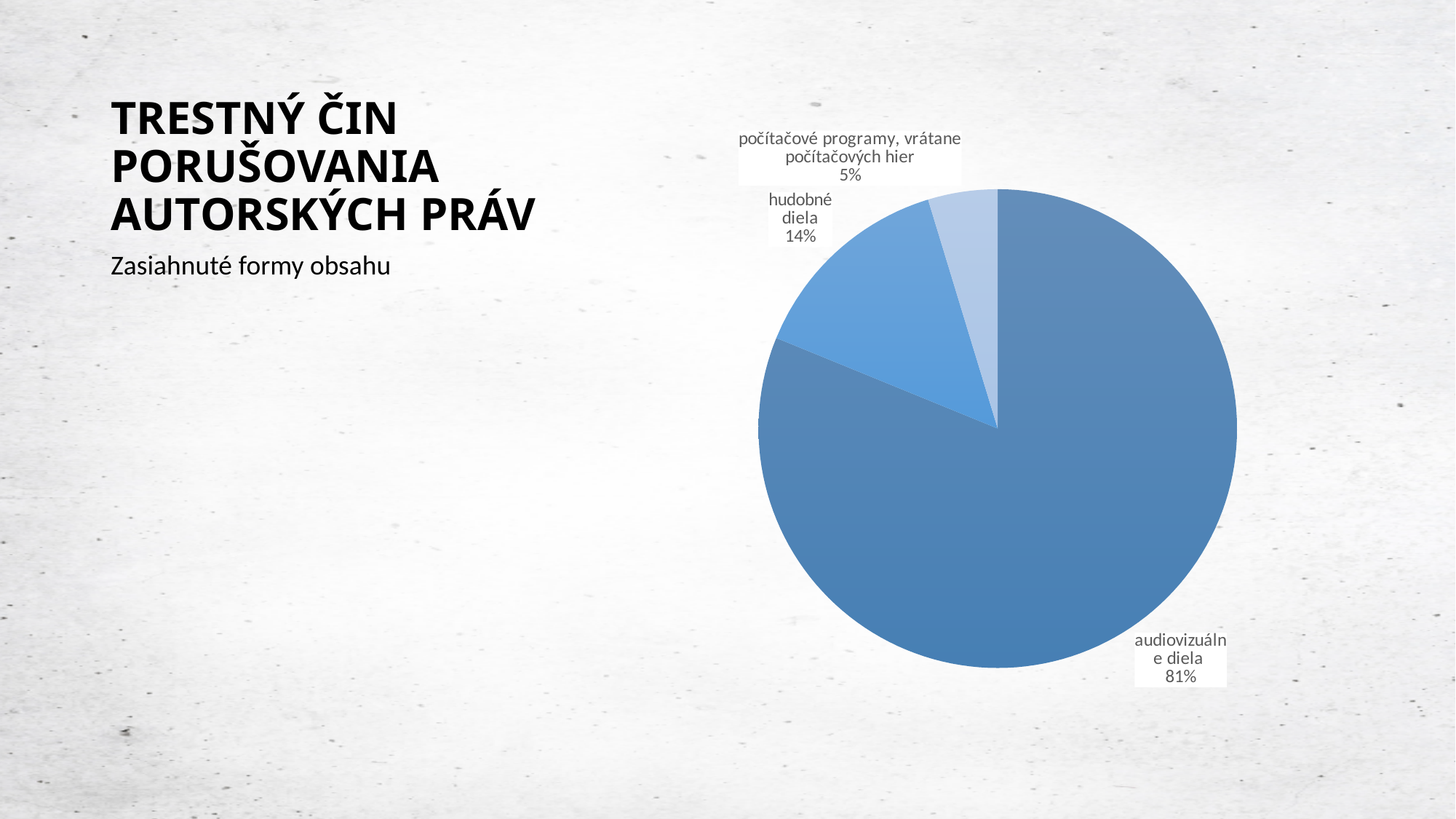
How many slices does the pie chart have? 3 Which category has the largest slice of the pie? audiovizuálne diela Which category has the smallest slice of the pie? počítačové programy, vrátane počítačových hier What is the difference in percentage points between the audiovizuálne diela slice and the hudobné diela slice? 67 Is the share for audiovizuálne diela greater or less than 50%? greater What is the subtitle text shown below the slide title, describing the chart? Zasiahnuté formy obsahu What share of the pie is labelled for audiovizuálne diela? 81% What kind of chart is shown on the slide? pie chart Which slice is larger: hudobné diela or počítačové programy, vrátane počítačových hier? hudobné diela What share of the pie is labelled for hudobné diela? 14% What share of the pie is labelled for počítačové programy, vrátane počítačových hier? 5% What is the difference in percentage points between the hudobné diela slice and the počítačové programy, vrátane počítačových hier slice? 9